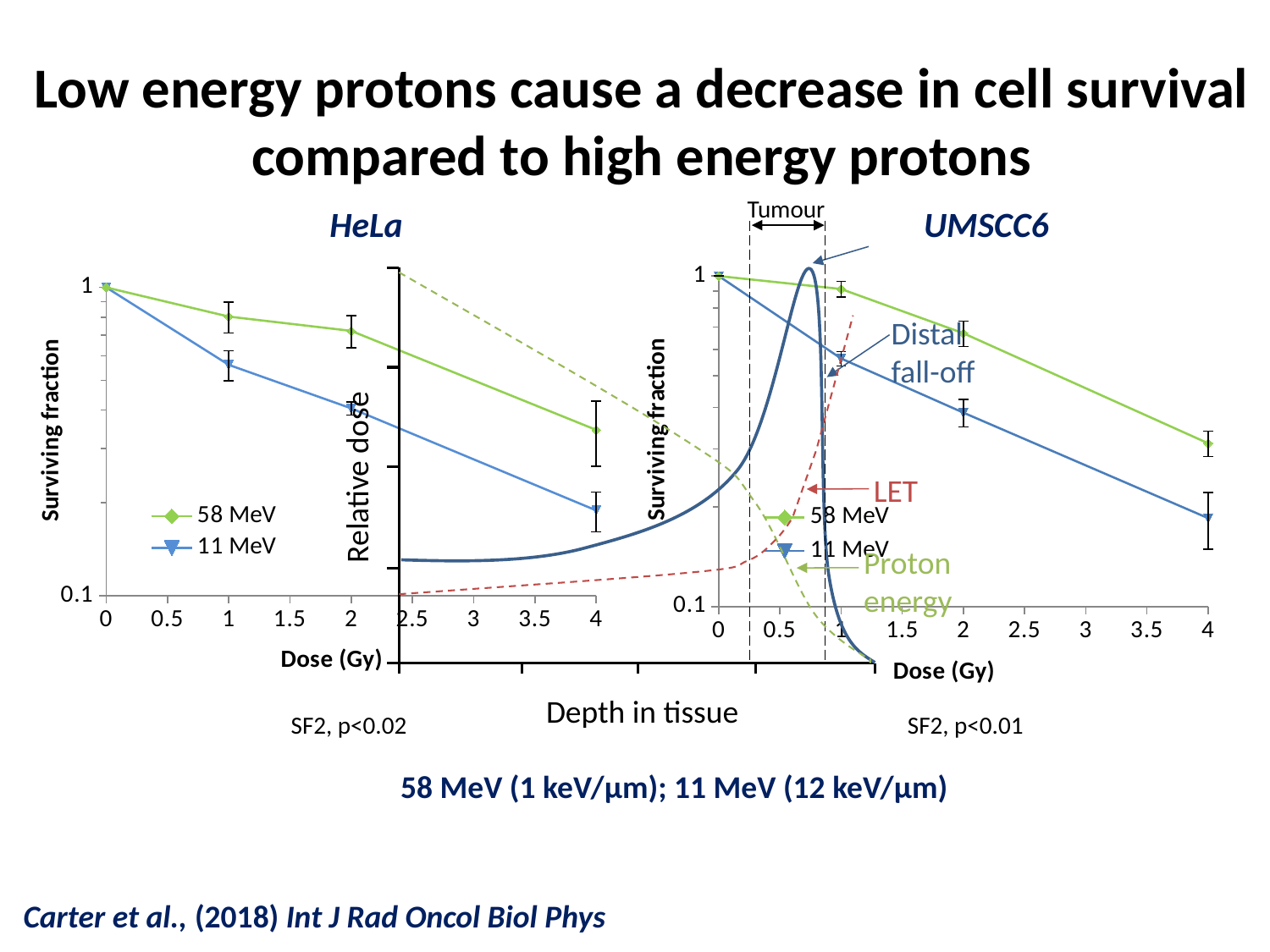
What is the x-axis label of the UMSCC6 chart? Dose (Gy) What kind of chart is the HeLa chart on the left? line chart In the UMSCC6 chart, does the surviving fraction for 58 MeV rise or fall as dose increases? fall In the UMSCC6 chart, is the surviving fraction for 58 MeV at 4 Gy greater or less than 1? less In the HeLa chart, does the surviving fraction for 11 MeV rise or fall as dose increases? fall In the HeLa chart, which series has the higher surviving fraction at a dose of 4 Gy, 58 MeV or 11 MeV? 58 MeV In the HeLa chart, what is the surviving fraction for 58 MeV at a dose of 0 Gy? 1 How many dose points are plotted for the 58 MeV series in the UMSCC6 chart? 4 What are the two series named in the legend of the UMSCC6 chart? 58 MeV and 11 MeV In the HeLa chart, is the surviving fraction for 11 MeV at 4 Gy greater or less than 0.1? greater In the UMSCC6 chart, which series has the lower surviving fraction at a dose of 2 Gy, 58 MeV or 11 MeV? 11 MeV How many series does the legend of the HeLa chart list? 2